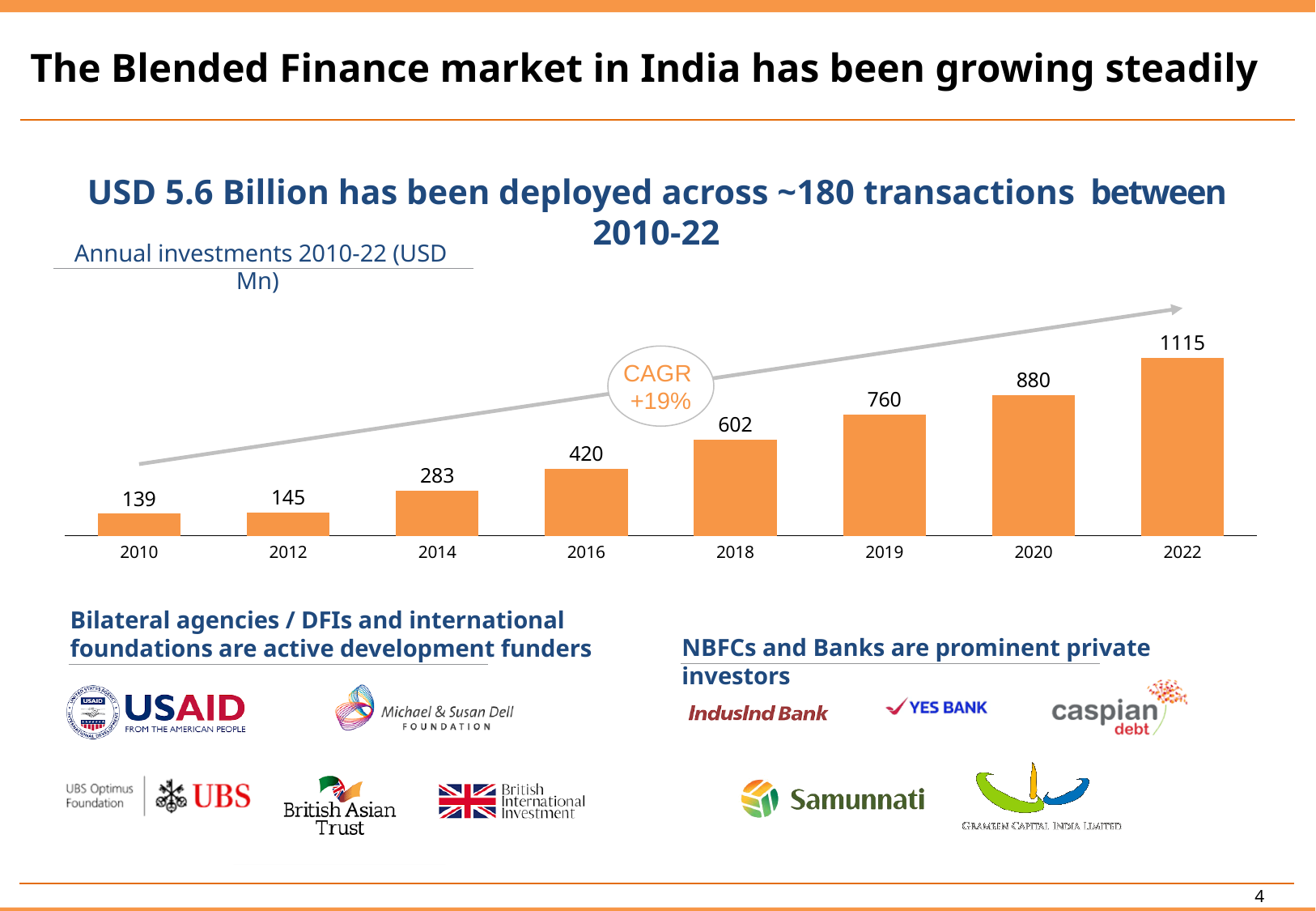
What CAGR is shown on the chart? +19% What is the difference between the annual investment in 2022 and in 2010? 976 Which year has the highest annual investment? 2022 Which year has the lowest annual investment? 2010 How many years are shown on the x axis of the chart? 8 What kind of chart is used to show annual investments 2010-22? Bar chart What is the title of the chart? Annual investments 2010-22 (USD Mn) What is the annual investment value for 2016? 420 Which is larger, the annual investment in 2014 or in 2012? 2014 What is the difference between the annual investment in 2019 and in 2018? 158 Do the annual investment values rise or fall from 2010 to 2022? Rise What is the annual investment value for 2020? 880